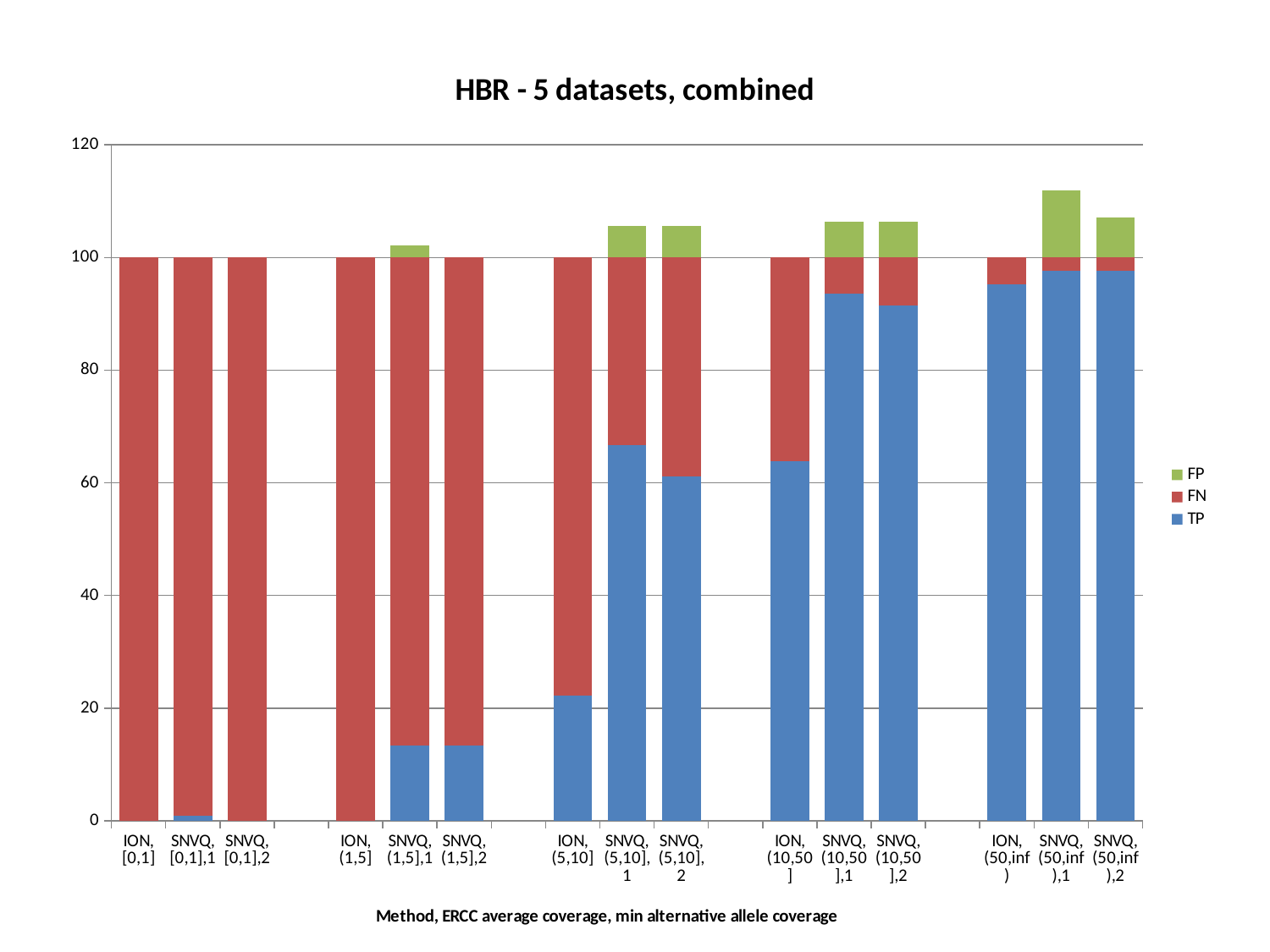
Is the TP value for SNVQ, (1,5],1 greater or less than 20? less Does the TP portion of the bars generally rise or fall moving from left to right along the x axis? Rise How many series does the legend list? 3 Is the TP value for SNVQ, (5,10],1 greater or less than 60? greater How many bars (categories) are plotted along the x axis? 15 What is the total height of the stacked bar for ION, [0,1]? 100 What kind of chart is shown on the slide? Stacked bar chart Is the TP value for ION, (50,inf) greater or less than 80? greater Which category has the tallest stacked bar overall? SNVQ, (50,inf),1 What is the title of the chart? HBR - 5 datasets, combined Which has the larger TP value: SNVQ, (10,50],1 or ION, (10,50]? SNVQ, (10,50],1